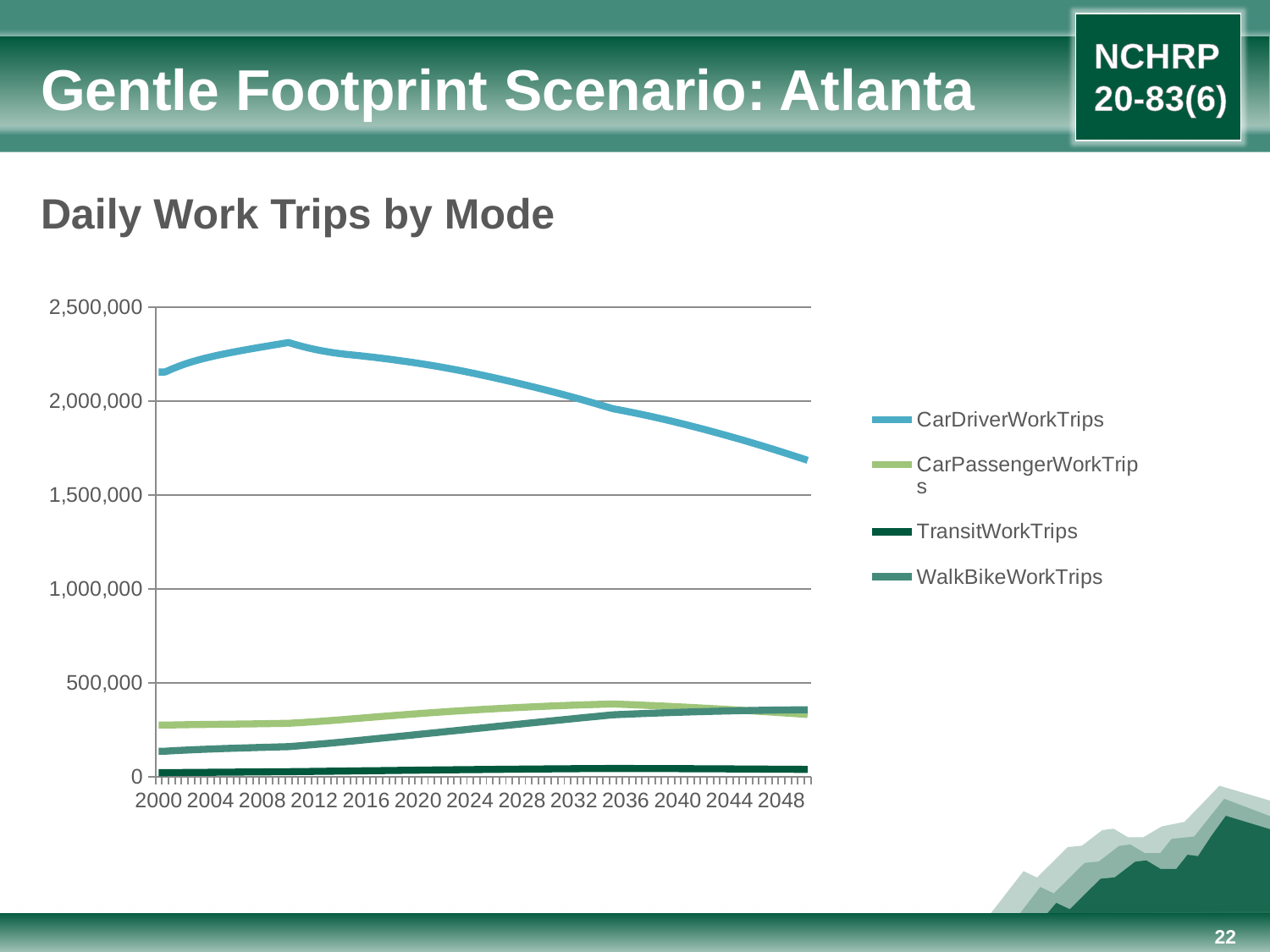
Does the CarDriverWorkTrips line rise or fall between 2012 and 2048? fall What kind of chart is shown on the slide? line chart Is the value for CarPassengerWorkTrips in 2000 greater or less than 500,000? less Which series has the highest values throughout the chart? CarDriverWorkTrips Does the WalkBikeWorkTrips line rise or fall between 2000 and 2036? rise Is the value for CarDriverWorkTrips in 2048 greater or less than 2,000,000? less What is the title of the chart? Daily Work Trips by Mode How many year labels are shown on the x axis? 13 Which series has the lowest values throughout the chart? TransitWorkTrips In 2000, which is larger: CarPassengerWorkTrips or WalkBikeWorkTrips? CarPassengerWorkTrips Is the value for CarDriverWorkTrips in 2000 greater or less than 2,000,000? greater How many series does the legend list? 4